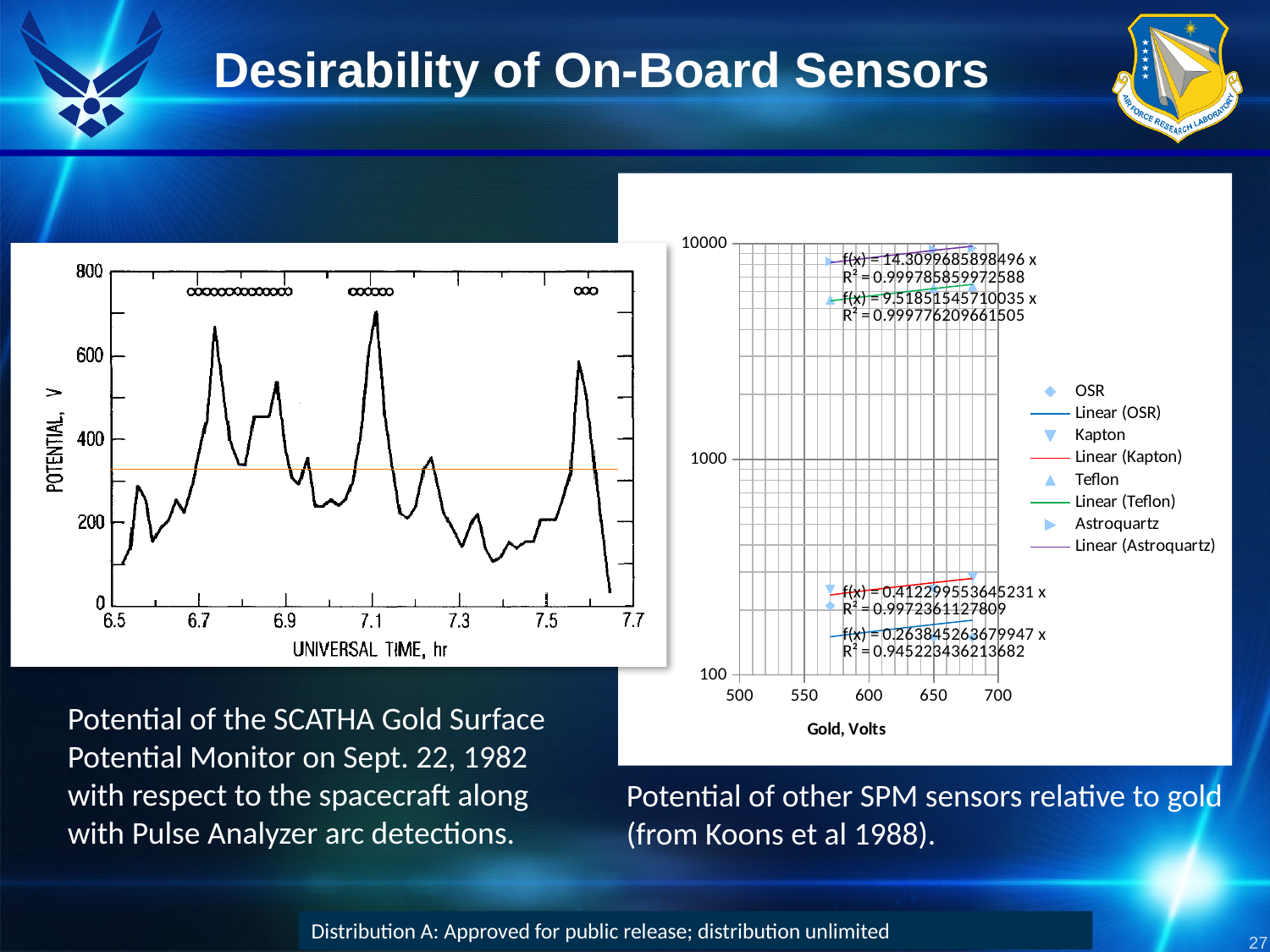
In the right chart, what is the R² value shown for the trendline f(x) = 14.3099685898496 x? 0.999785859972588 In the right chart, are the Astroquartz values greater or less than 1000? greater In the right chart, what is the x-axis title? Gold, Volts In the right chart, which sensor series has the lowest potential values? OSR In the right chart, what is the slope shown in the trendline equation with R² = 0.945223436213682? 0.263845263679947 In the right chart, how many entries does the legend list? 8 What kind of chart is the chart on the left showing potential versus universal time? line chart In the right chart, which sensor series has the highest potential values? Astroquartz What kind of chart is the chart on the right titled with the x-axis 'Gold, Volts'? scatter chart with linear trendlines In the right chart, are the OSR values greater or less than 1000? less In the left chart, what is the label of the x-axis? UNIVERSAL TIME, hr In the left chart, is the peak potential near 7.1 hr greater or less than 600 V? greater